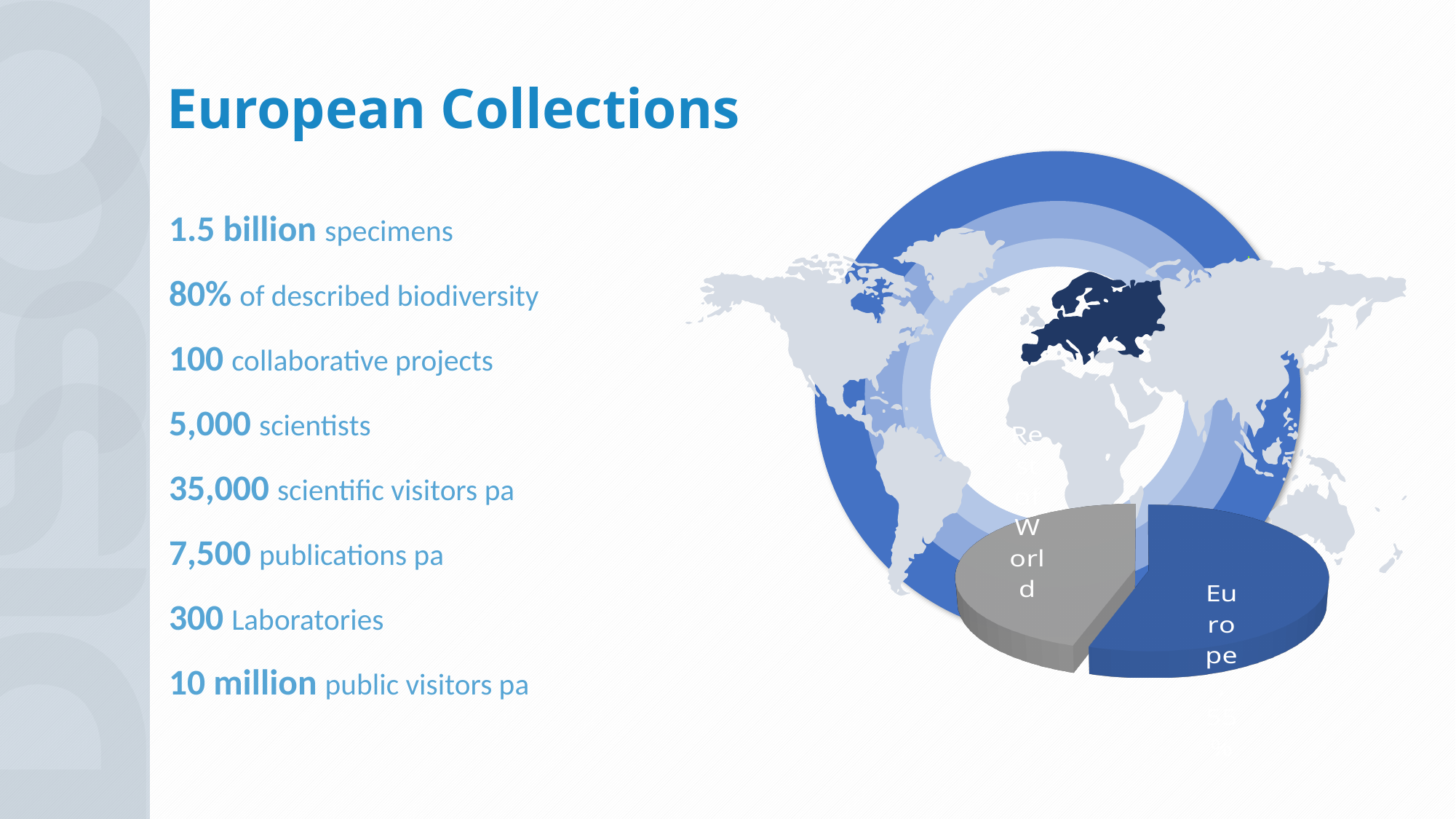
Which slice of the pie chart is larger, Europe or Rest of World? Europe Which slice of the pie chart is the largest? Europe What colour is the Europe slice of the pie chart? blue How many slices does the pie chart have? 2 What kind of chart is shown on the slide? pie chart What colour is the Rest of World slice of the pie chart? grey Which slice of the pie chart is the smallest? Rest of World